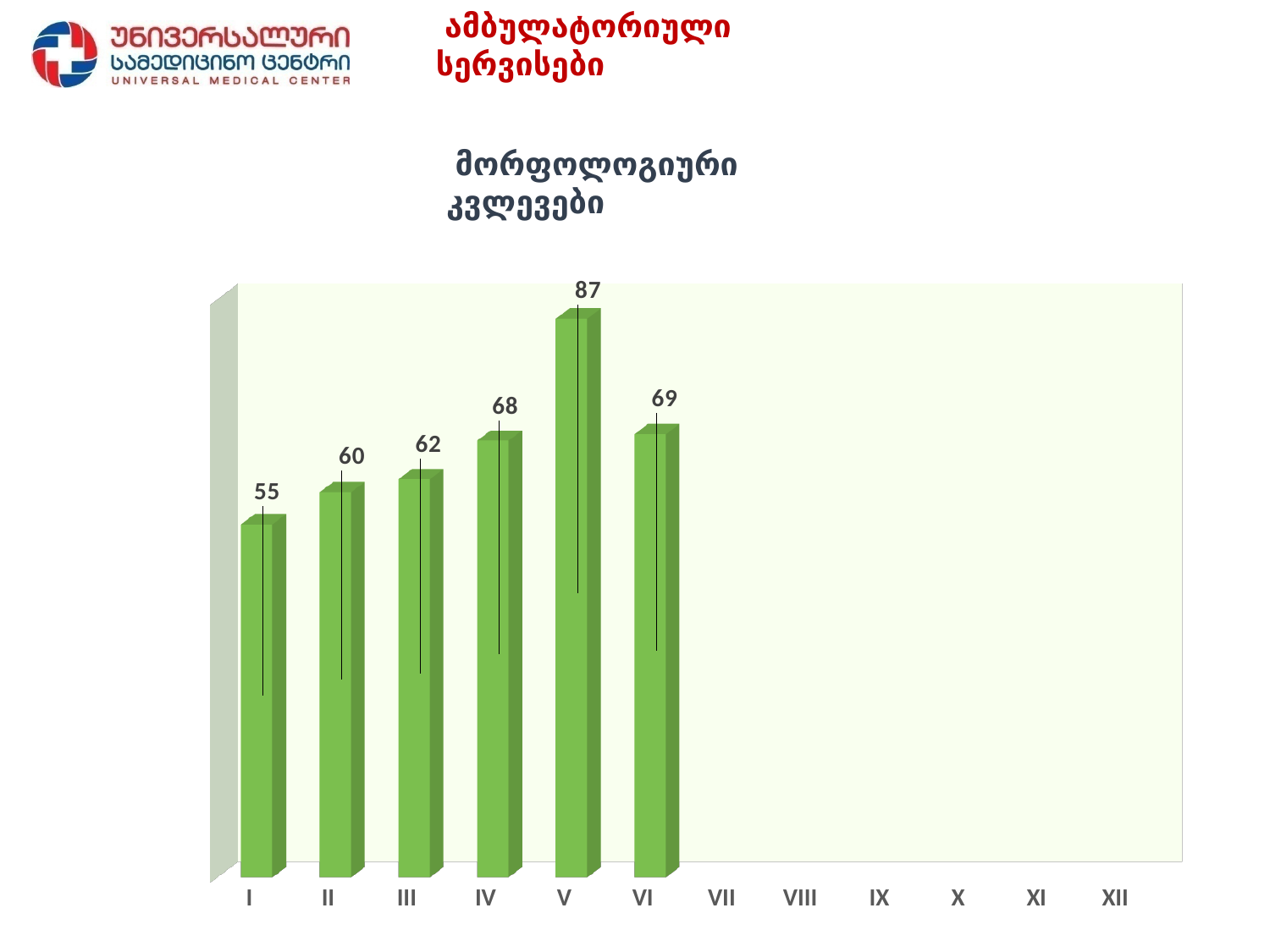
What is the difference between the values for II and I? 5 What value is shown for category III? 62 Do the values rise or fall from category I to category V? Rise What value is shown for category V? 87 Which is larger, the value for VI or the value for IV? VI Which category has the lowest value among the bars shown? I Which category has the highest value? V What is the difference between the values for V and IV? 19 What value is shown for category I? 55 What kind of chart is shown on the slide? Bar chart How many categories have a bar with a value shown? 6 What value is shown for category VI? 69